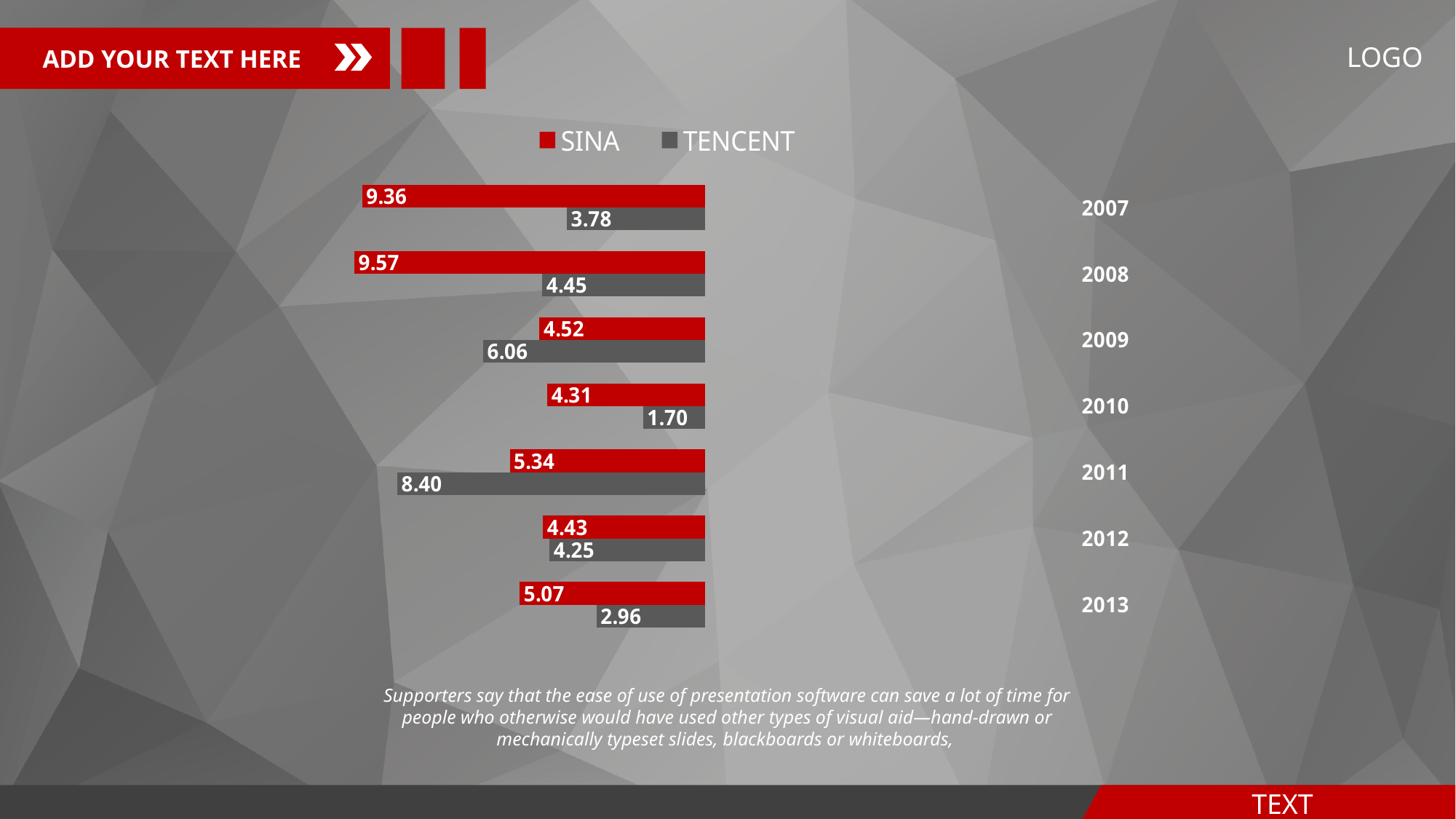
What kind of chart is shown on the slide? Bar chart How many years are shown on the chart? 7 What is the difference between the TENCENT values for 2011 and 2013? 5.44 What is the SINA value for 2007? 9.36 Which is larger in 2009, the SINA value or the TENCENT value? TENCENT Which year has the highest SINA value? 2008 How many series does the legend list? 2 Which colour represents SINA in the legend? Red Which year has the lowest TENCENT value? 2010 What is the TENCENT value for 2011? 8.40 What is the TENCENT value for 2010? 1.70 What is the difference between the SINA and TENCENT values in 2007? 5.58